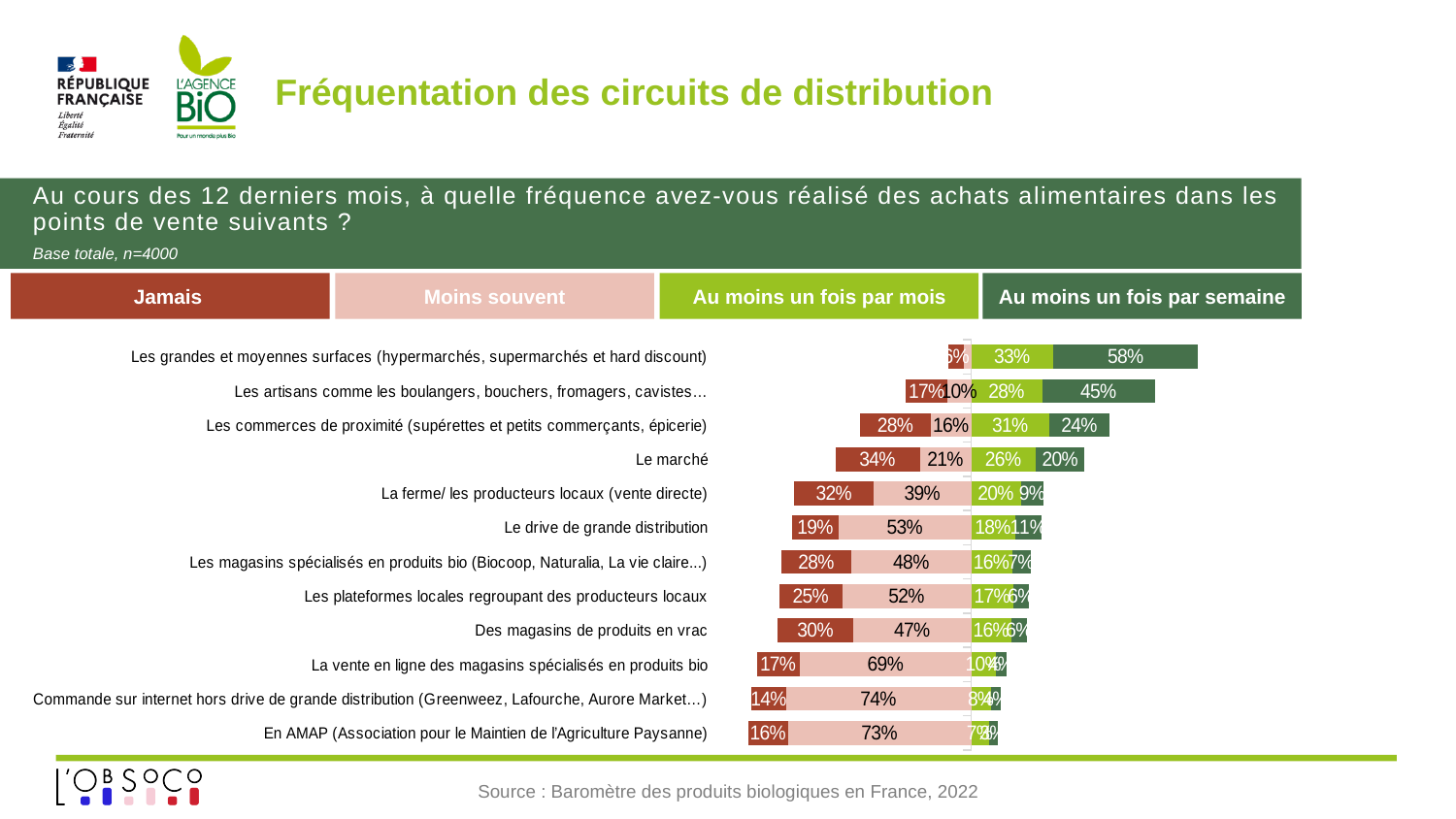
Which category has the highest 'Moins souvent' value? Commande sur internet hors drive de grande distribution (Greenweez, Lafourche, Aurore Market…) What is the 'Au moins une fois par semaine' value for 'Les grandes et moyennes surfaces (hypermarchés, supermarchés et hard discount)'? 58% What kind of chart is shown on the slide? stacked bar chart What is the 'Au moins une fois par mois' value for 'Les commerces de proximité (supérettes et petits commerçants, épicerie)'? 31% How many series does the legend list? 4 How many points of sale (categories) are shown in the chart? 12 What is the 'Moins souvent' value for 'Commande sur internet hors drive de grande distribution (Greenweez, Lafourche, Aurore Market…)'? 74% Which category has the highest 'Au moins une fois par semaine' value? Les grandes et moyennes surfaces (hypermarchés, supermarchés et hard discount) Which is larger: the 'Jamais' value for 'La ferme/ les producteurs locaux (vente directe)' or for 'Le drive de grande distribution'? La ferme/ les producteurs locaux (vente directe) What is the difference between the 'Au moins une fois par semaine' values for 'Les artisans comme les boulangers, bouchers, fromagers, cavistes…' and 'Le marché'? 25% What is the title of the slide containing the chart? Fréquentation des circuits de distribution What is the 'Jamais' value for 'Le marché'? 34%